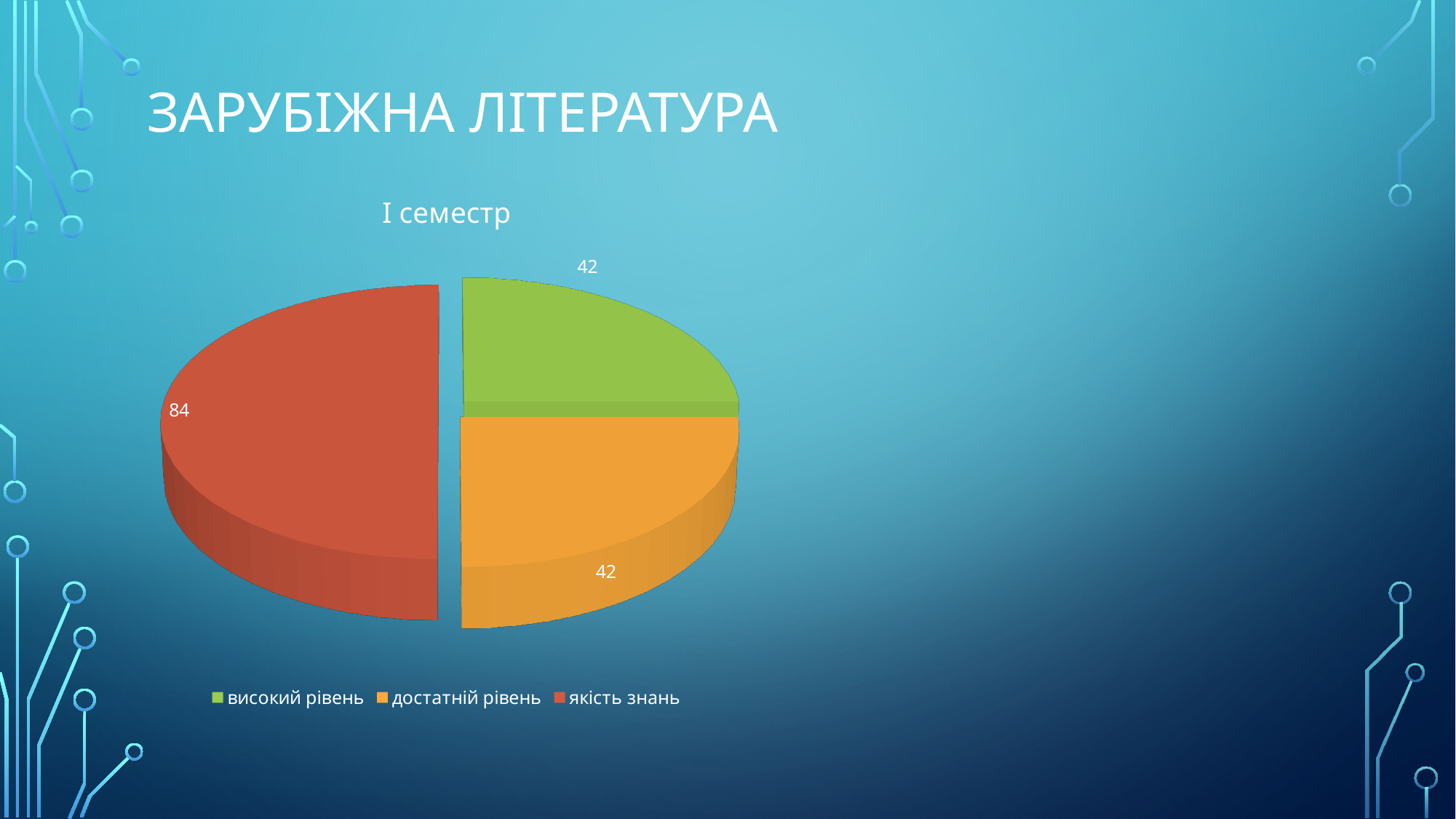
Which category has the largest slice? якість знань How many entries does the legend list? 3 What is the value for якість знань? 84 What kind of chart is shown on the slide? pie chart What is the difference between the values for якість знань and високий рівень? 42 What colour is the slice for достатній рівень? orange Which is larger, the value for якість знань or the value for достатній рівень? якість знань What is the title of the chart? І семестр What share of the pie does якість знань represent? 50% What is the value for високий рівень? 42 What is the value for достатній рівень? 42 How many slices does the pie chart have? 3